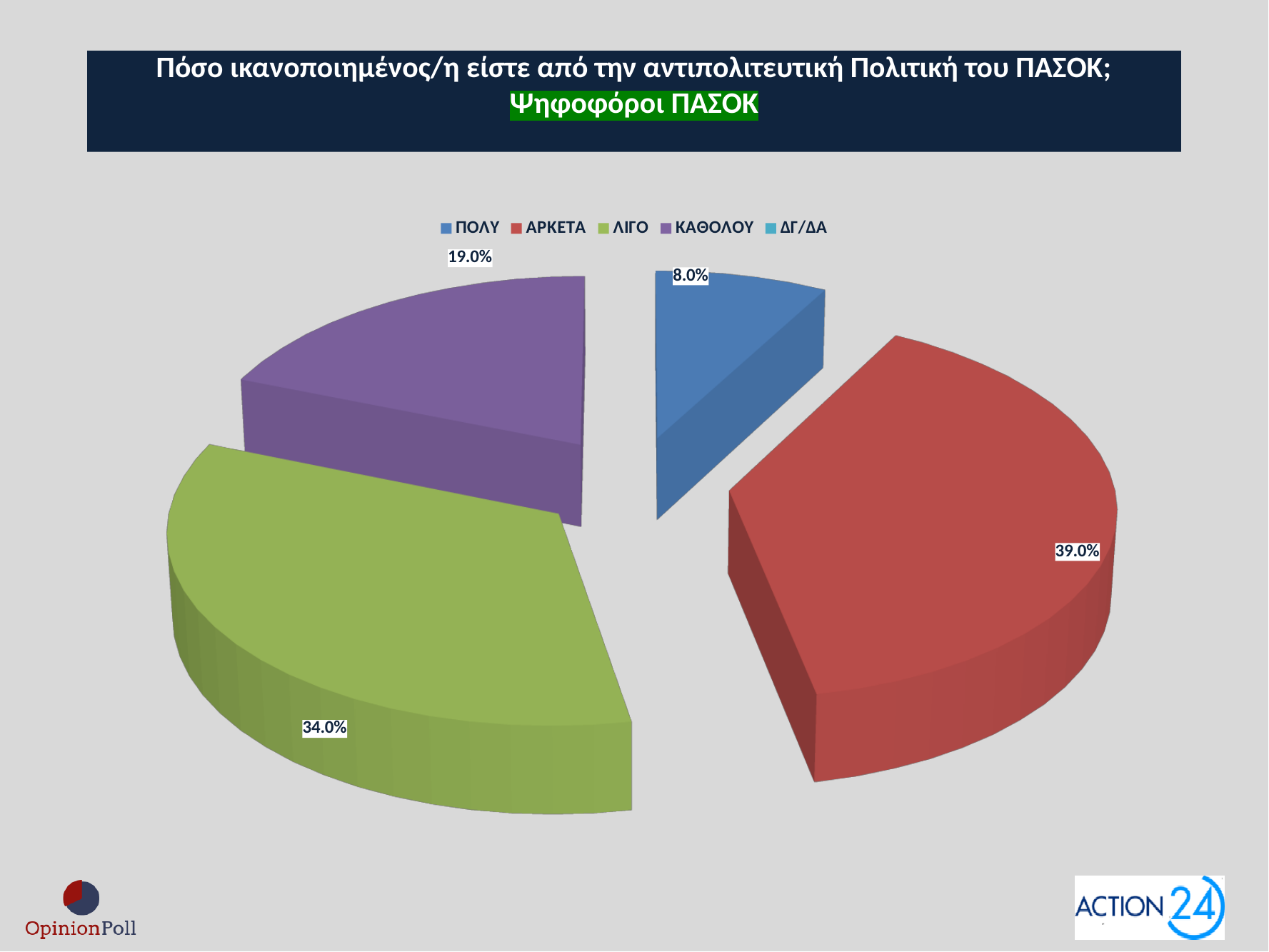
Which is larger, the share for ΚΑΘΟΛΟΥ or the share for ΠΟΛΥ? ΚΑΘΟΛΟΥ What percentage is shown for ΚΑΘΟΛΟΥ? 19.0% What percentage is shown for ΑΡΚΕΤΑ? 39.0% What is the difference in percentage points between ΑΡΚΕΤΑ and ΛΙΓΟ? 5.0 What percentage is shown for ΠΟΛΥ? 8.0% Among the slices with a printed value, which category has the smallest share? ΠΟΛΥ What is the combined share of ΑΡΚΕΤΑ and ΛΙΓΟ? 73.0% What kind of chart is shown on the slide? pie chart What percentage is shown for ΛΙΓΟ? 34.0% How many entries does the legend list? 5 Which category has the largest slice of the pie? ΑΡΚΕΤΑ What colour is the slice for ΛΙΓΟ? green